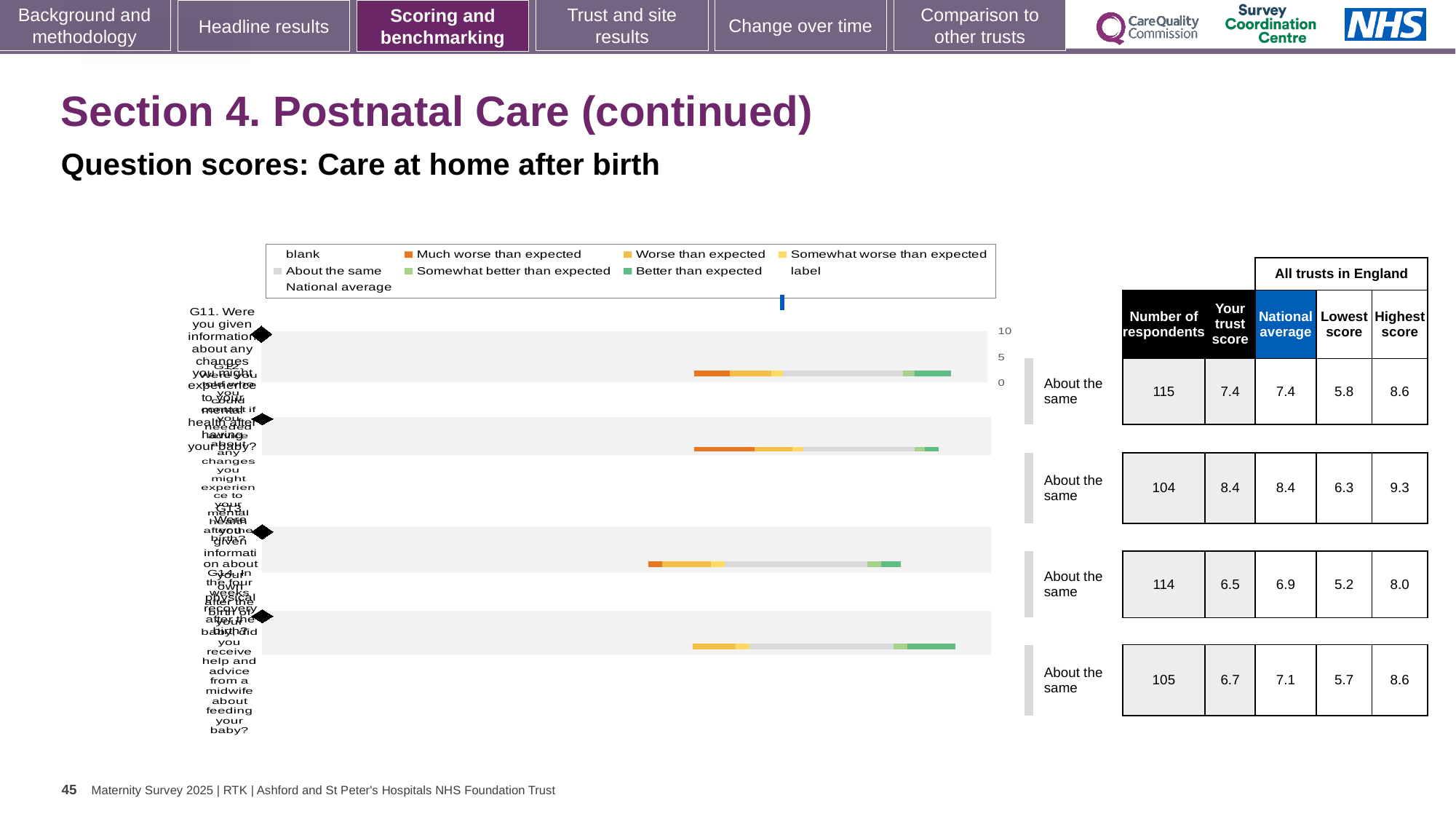
In the table beside the chart, what is the number of respondents for the fourth (bottom) question? 105 For the third question, what is the difference between the national average and the trust score? 0.4 What benchmark category is shown next to each of the four questions? About the same What colour represents 'Much worse than expected' in the legend? orange Which row of the table has the lowest 'Lowest score' value? the third row (5.2) Which row of the table has the highest 'Your trust score'? the second row (8.4) What kind of chart is shown on the slide? bar chart For the fourth question, which is larger: the trust score or the national average? national average In the table beside the chart, what is the 'Your trust score' for the second question? 8.4 In the table beside the chart, what is the number of respondents for the first (top) question? 115 How many question bars are plotted in the chart? 4 In the table beside the chart, what is the highest score for the second question? 9.3